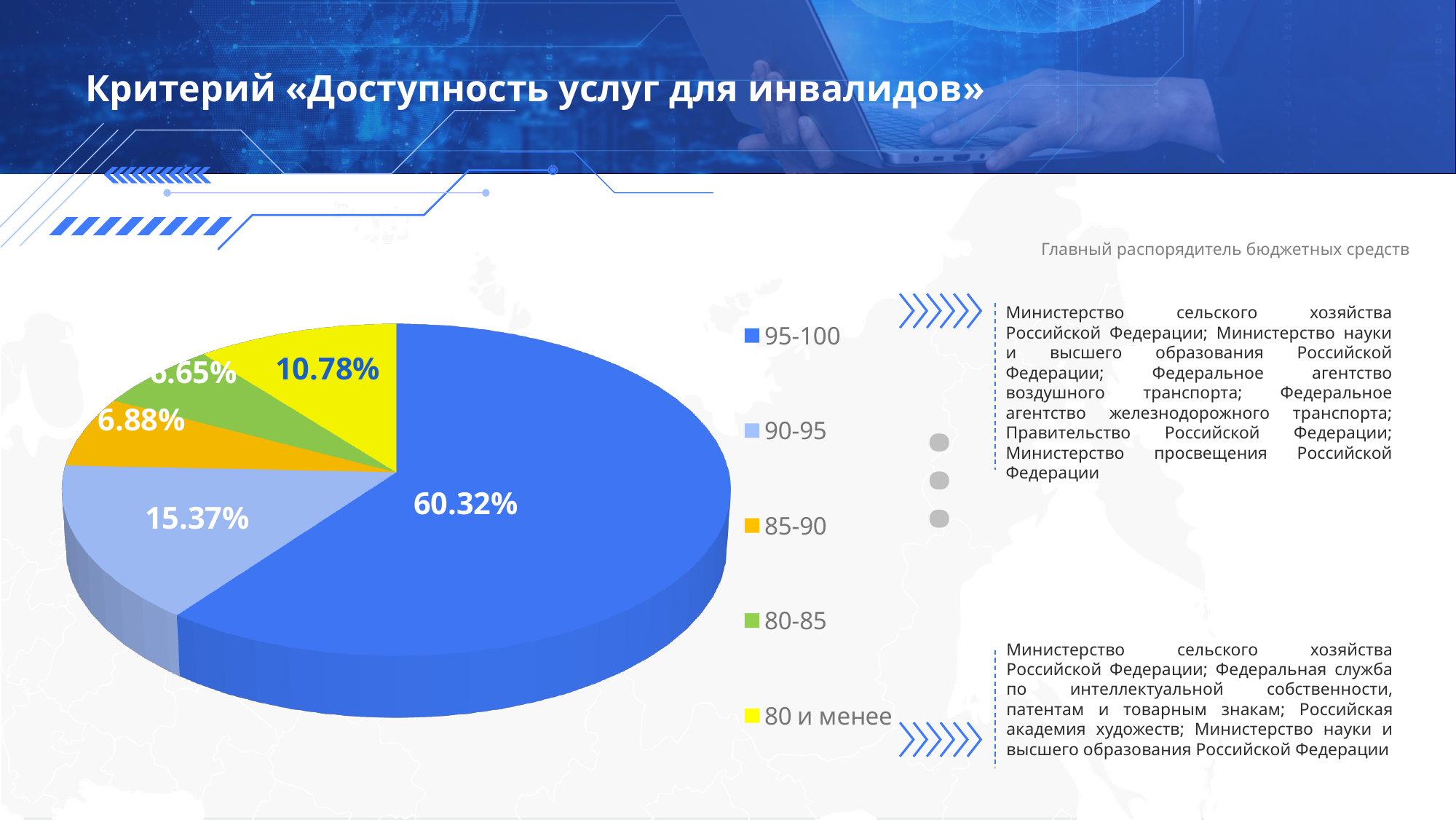
What share of the pie does the 90-95 category have? 15.37% What is the difference between the 90-95 share and the "80 и менее" share? 4.59% How many categories does the pie chart have? 5 Which category has the largest slice of the pie? 95-100 Which is larger, the 90-95 slice or the "80 и менее" slice? 90-95 What colour is the 95-100 slice of the pie? blue What share of the pie does the 85-90 category have? 6.88% What share of the pie does the 95-100 category have? 60.32% What is the difference between the 95-100 share and the 90-95 share? 44.95% Is the share of the 95-100 category greater or less than 50%? greater What share of the pie does the "80 и менее" category have? 10.78% What kind of chart is shown on the slide? pie chart